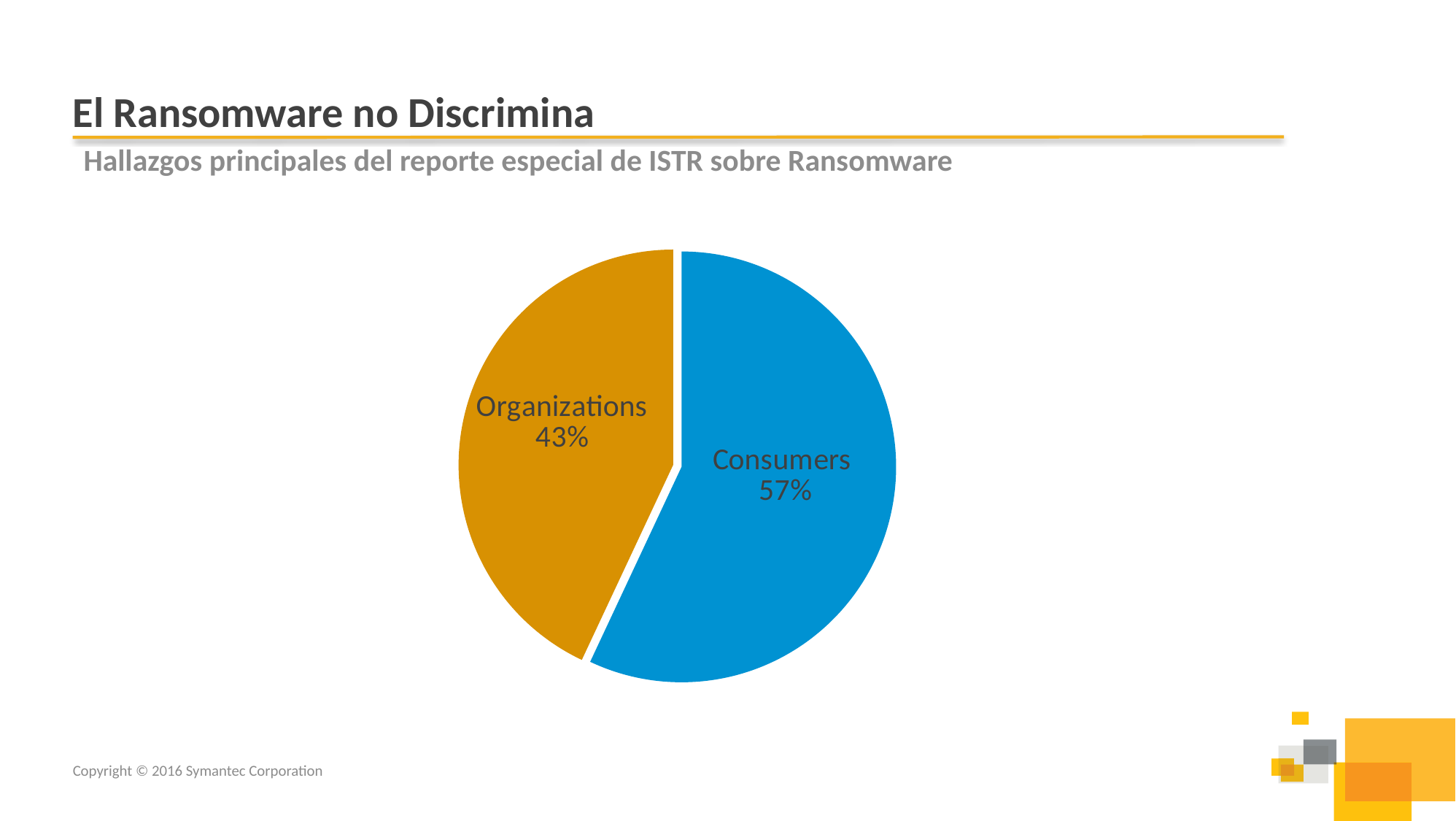
How many slices does the pie chart have? 2 What kind of chart is shown on the slide? pie chart Which slice of the pie is the largest? Consumers What is the difference in percentage points between the Consumers slice and the Organizations slice? 14 What colour is the Consumers slice? blue Which is larger, the Consumers slice or the Organizations slice? Consumers What colour is the Organizations slice? orange Which slice of the pie is the smallest? Organizations What percentage of the pie is labelled Consumers? 57% What share of the pie does the Organizations slice represent? 43% What percentage of the pie is labelled Organizations? 43%